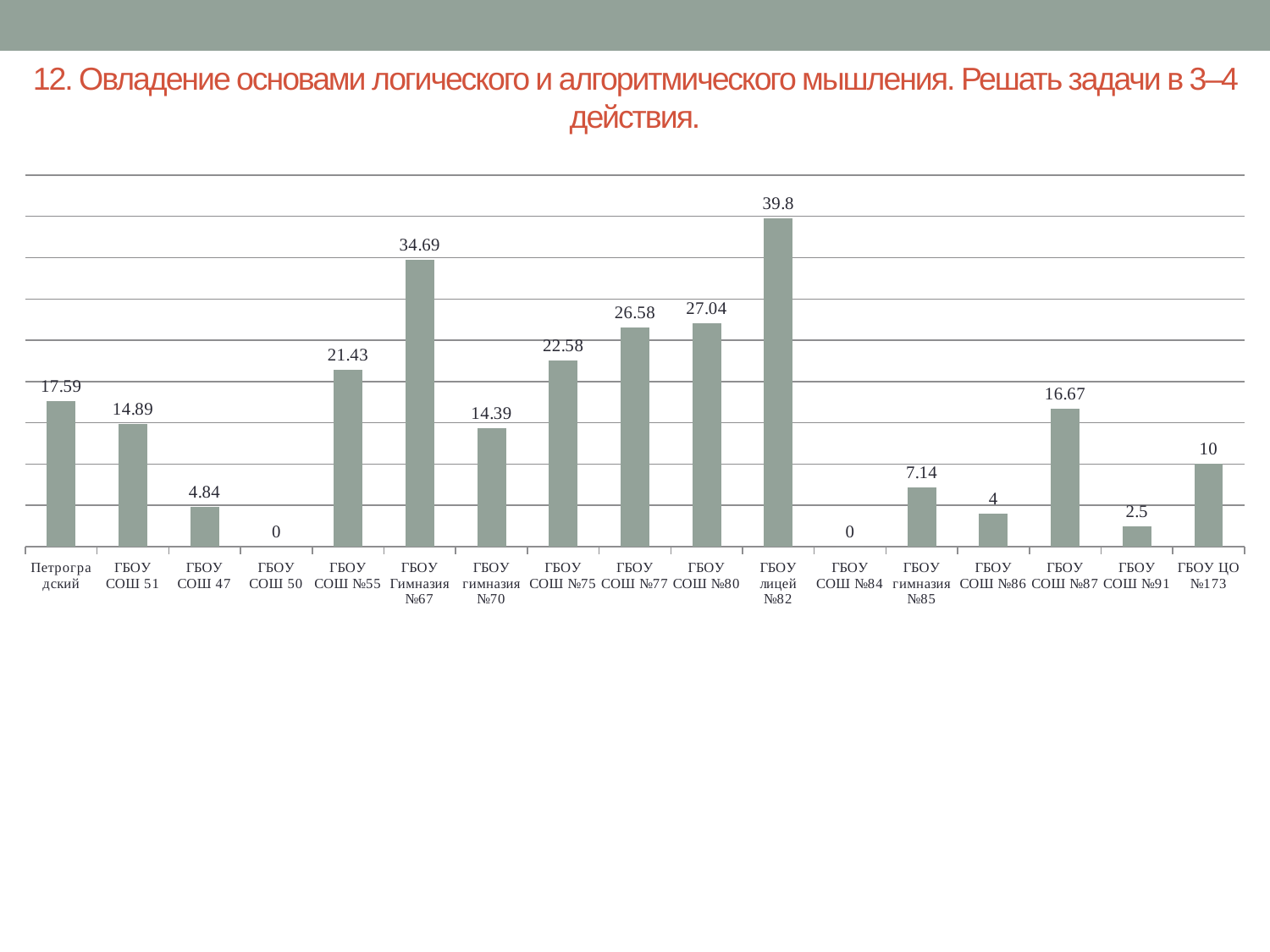
Which is larger, the value for ГБОУ СОШ 51 or the value for ГБОУ гимназия №70? ГБОУ СОШ 51 What is the value for ГБОУ Гимназия №67? 34.69 What is the value for ГБОУ лицей №82? 39.8 What kind of chart is shown on the slide? Bar chart Which is larger, the value for ГБОУ СОШ №87 or the value for ГБОУ ЦО №173? ГБОУ СОШ №87 How many categories have a value of 0? 2 What is the difference between the values for ГБОУ СОШ №80 and ГБОУ СОШ №77? 0.46 What is the value for ГБОУ СОШ №91? 2.5 Which category has the highest value? ГБОУ лицей №82 What is the difference between the values for ГБОУ лицей №82 and ГБОУ Гимназия №67? 5.11 What is the value for Петроградский? 17.59 How many categories are shown on the x axis? 17